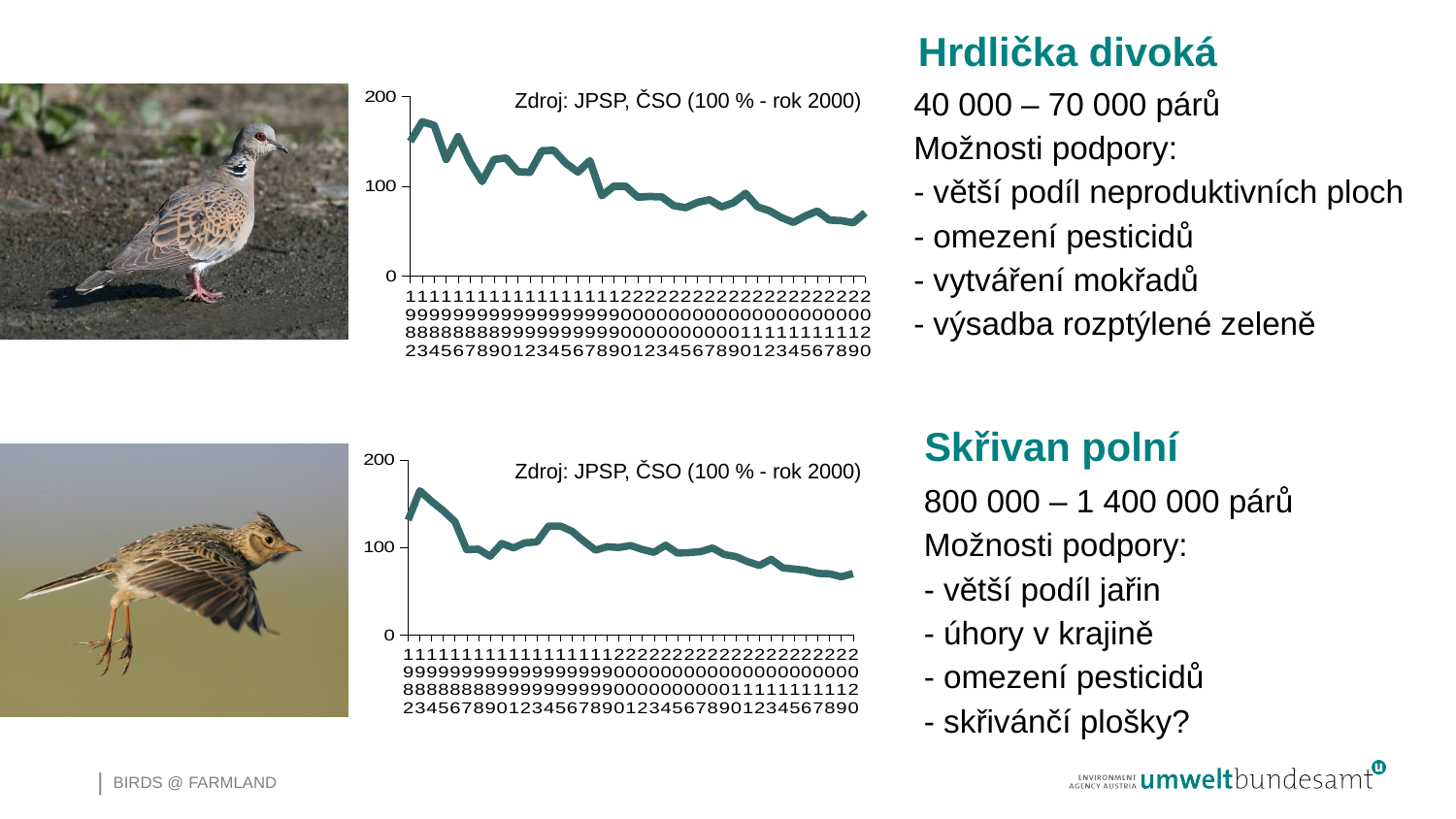
In the bottom chart (Skřivan polní), do the values generally rise or fall from 1982 to 2020? fall In the bottom chart (Skřivan polní), which is larger, the value for 1982 or the value for 2020? 1982 How many years (data points) are plotted on the x axis of the top chart (Hrdlička divoká)? 39 In the top chart (Hrdlička divoká), do the values generally rise or fall from 1982 to 2020? fall What kind of chart is the bottom chart (Skřivan polní)? line chart In the bottom chart (Skřivan polní), is the value for 2020 greater or less than 100? less In the top chart (Hrdlička divoká), is the value for 2020 greater or less than 100? less In the bottom chart (Skřivan polní), is the value for 1983 greater or less than 100? greater What kind of chart is the top chart (Hrdlička divoká)? line chart What is the highest value shown on the y axis of the bottom chart (Skřivan polní)? 200 In the top chart (Hrdlička divoká), which year has the highest value? 1983